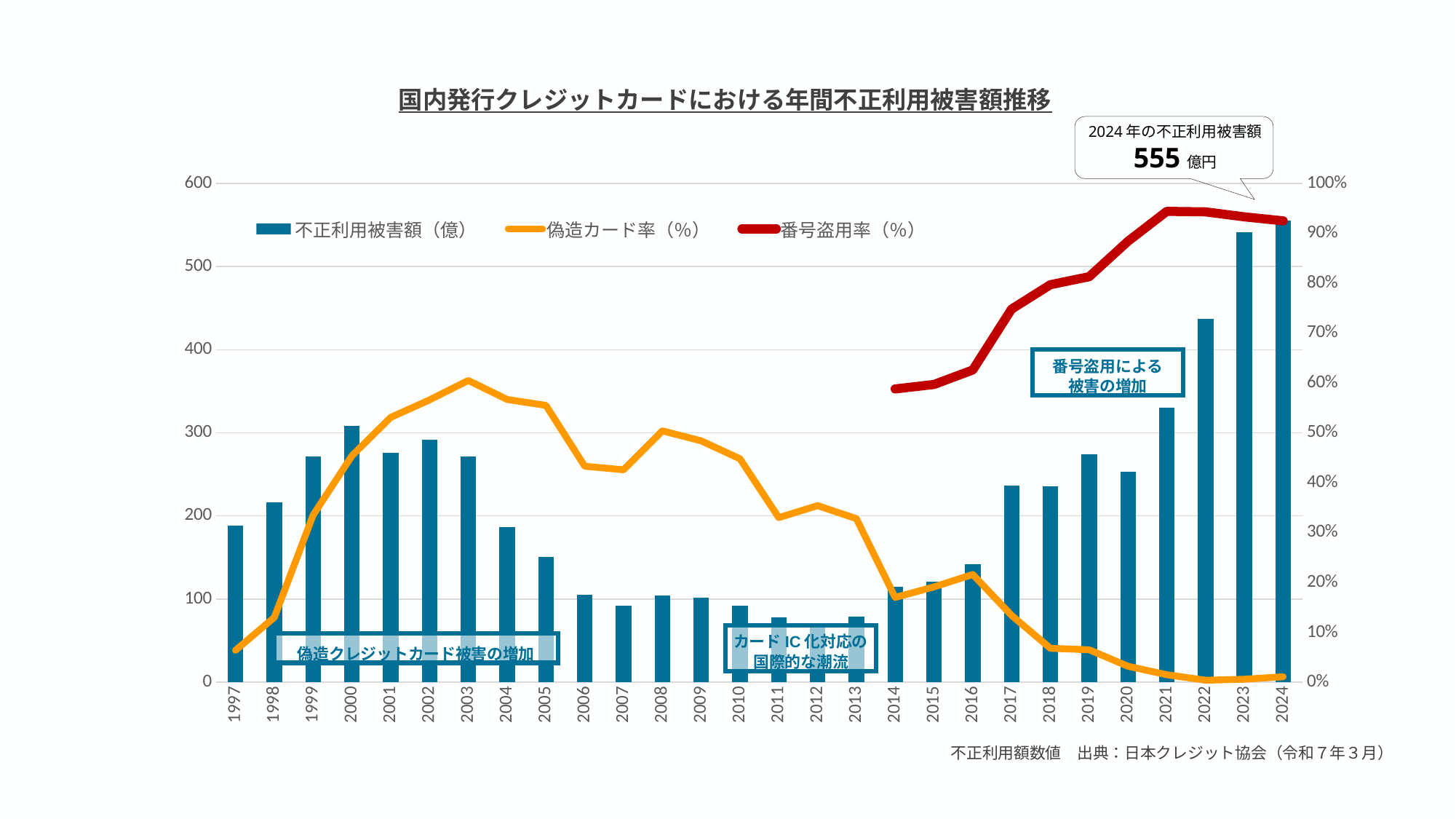
How many series does the legend list? 3 Is the 不正利用被害額 bar for 2000 greater or less than 300? greater Does the 番号盗用率 line rise or fall from 2014 to 2021? rise Which year has the larger 不正利用被害額 bar, 2000 or 2005? 2000 Which year has the highest 不正利用被害額 bar? 2024 Is the 不正利用被害額 bar for 2022 greater or less than 400? greater What is the value of 不正利用被害額 for 2024 as shown in the callout? 555 億円 How many years are shown on the x axis? 28 What kind of chart is this? Combined bar and line chart Which year has the larger 不正利用被害額 bar, 2020 or 2021? 2021 Is the 偽造カード率 value for 2003 greater or less than 50%? greater